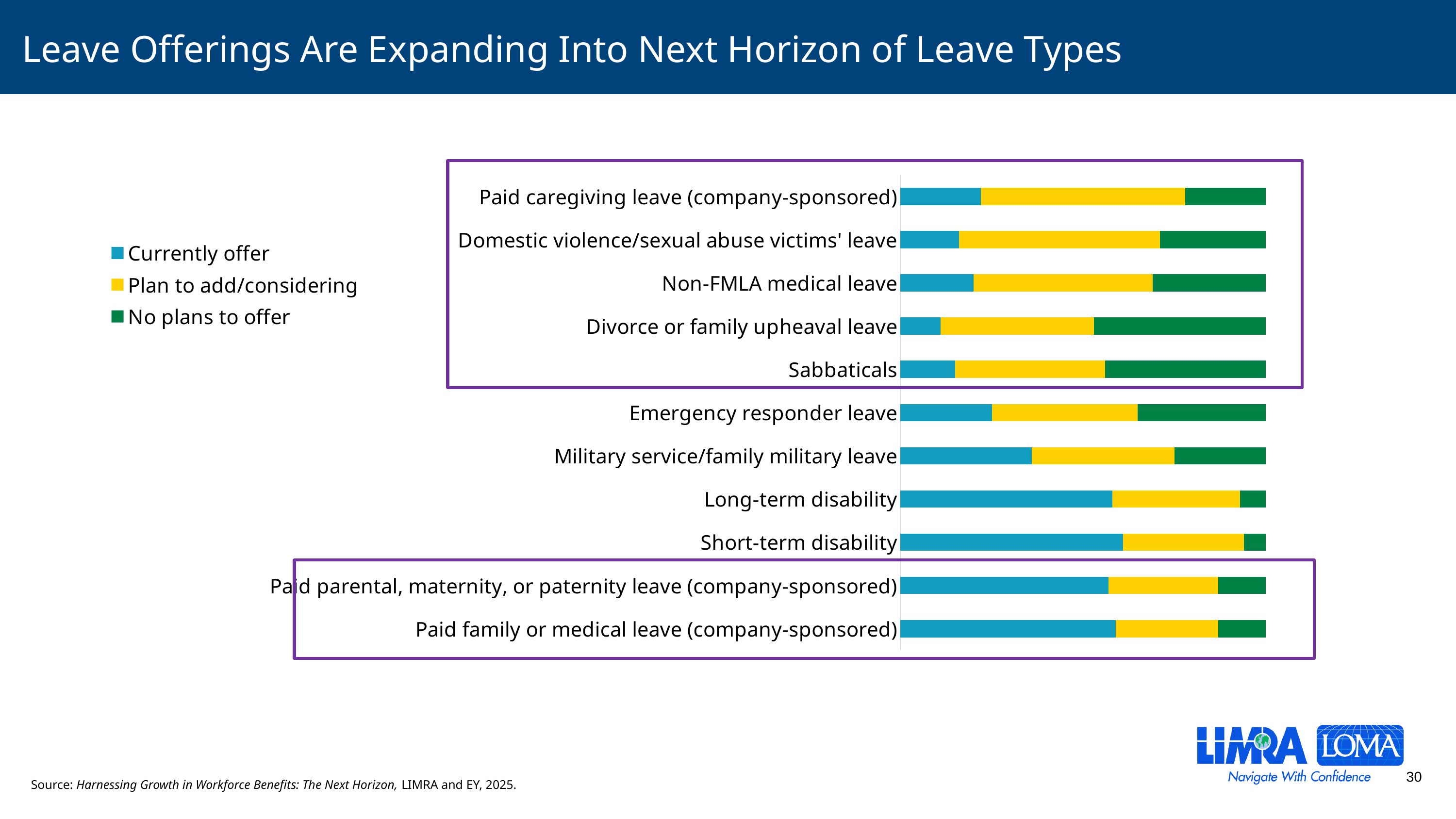
Which has the larger 'Currently offer' segment: Military service/family military leave or Divorce or family upheaval leave? Military service/family military leave Which has the larger 'Currently offer' segment: Emergency responder leave or Sabbaticals? Emergency responder leave What kind of chart is shown on the slide? Stacked bar chart Which has the larger 'Plan to add/considering' segment: Paid caregiving leave (company-sponsored) or Short-term disability? Paid caregiving leave (company-sponsored) Which series is shown in blue in the chart? Currently offer How many leave types (categories) are plotted in the chart? 11 How many series does the chart legend list? 3 What is the title of the slide containing the chart? Leave Offerings Are Expanding Into Next Horizon of Leave Types